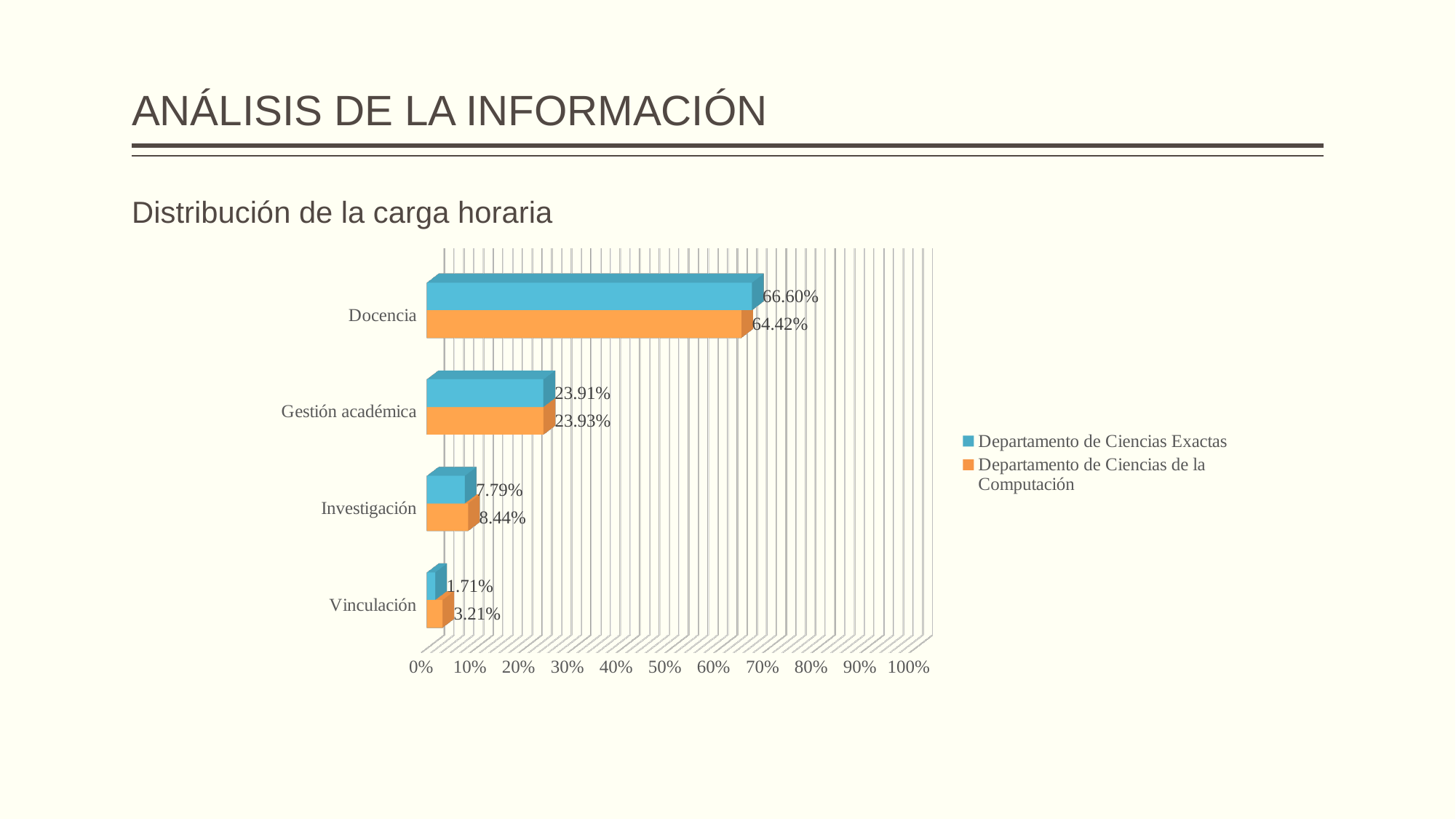
What is the value for Vinculación for Departamento de Ciencias Exactas? 1.71% What is the value for Docencia for Departamento de Ciencias de la Computación? 64.42% What is the value for Docencia for Departamento de Ciencias Exactas? 66.60% Which category has the highest value for Departamento de Ciencias Exactas? Docencia What is the title of the chart? Distribución de la carga horaria Which category has the lowest value for Departamento de Ciencias de la Computación? Vinculación What is the difference between the Docencia values for Departamento de Ciencias Exactas and Departamento de Ciencias de la Computación? 2.18% What kind of chart is shown on the slide? Bar chart How many categories are shown on the chart? 4 What is the value for Investigación for Departamento de Ciencias de la Computación? 8.44% For Vinculación, which department has the larger value? Departamento de Ciencias de la Computación How many series does the legend list? 2